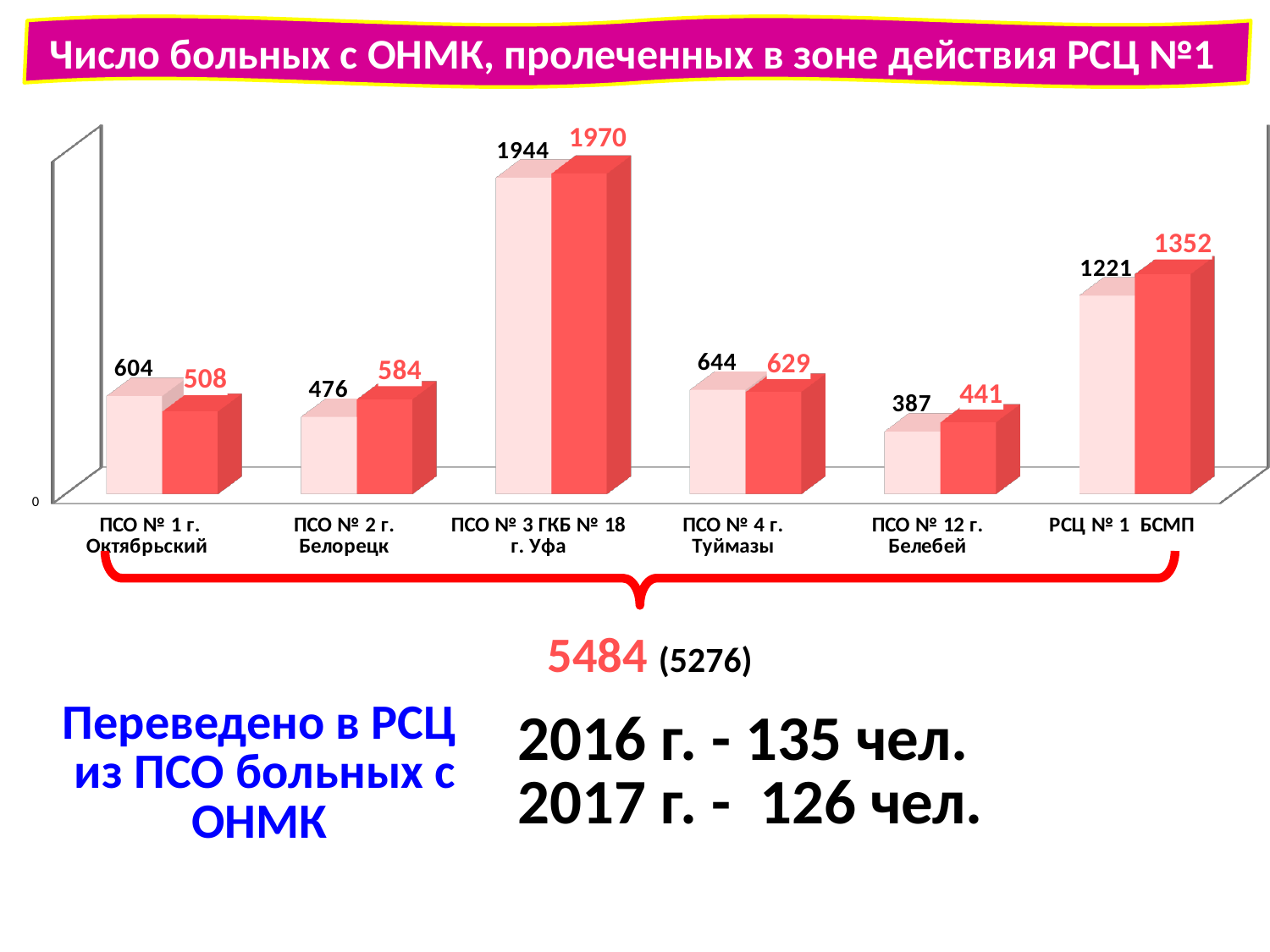
Which red bar is larger, ПСО № 4 г. Туймазы or ПСО № 2 г. Белорецк? ПСО № 4 г. Туймазы How many categories are shown on the x axis of the chart? 6 What kind of chart is shown on the slide? bar chart What is the value of the red bar for ПСО № 12 г. Белебей? 441 What is the value of the red bar for РСЦ № 1 БСМП? 1352 Which category has the lowest light pink bar? ПСО № 12 г. Белебей What is the value of the light pink bar for ПСО № 3 ГКБ № 18 г. Уфа? 1944 Which category has the highest red bar? ПСО № 3 ГКБ № 18 г. Уфа What is the difference between the red bar and the light pink bar for ПСО № 2 г. Белорецк? 108 What is the difference between the red bar and the light pink bar for РСЦ № 1 БСМП? 131 What is the title of the slide? Число больных с ОНМК, пролеченных в зоне действия РСЦ №1 For ПСО № 1 г. Октябрьский, which bar is larger, the light pink one or the red one? the light pink one